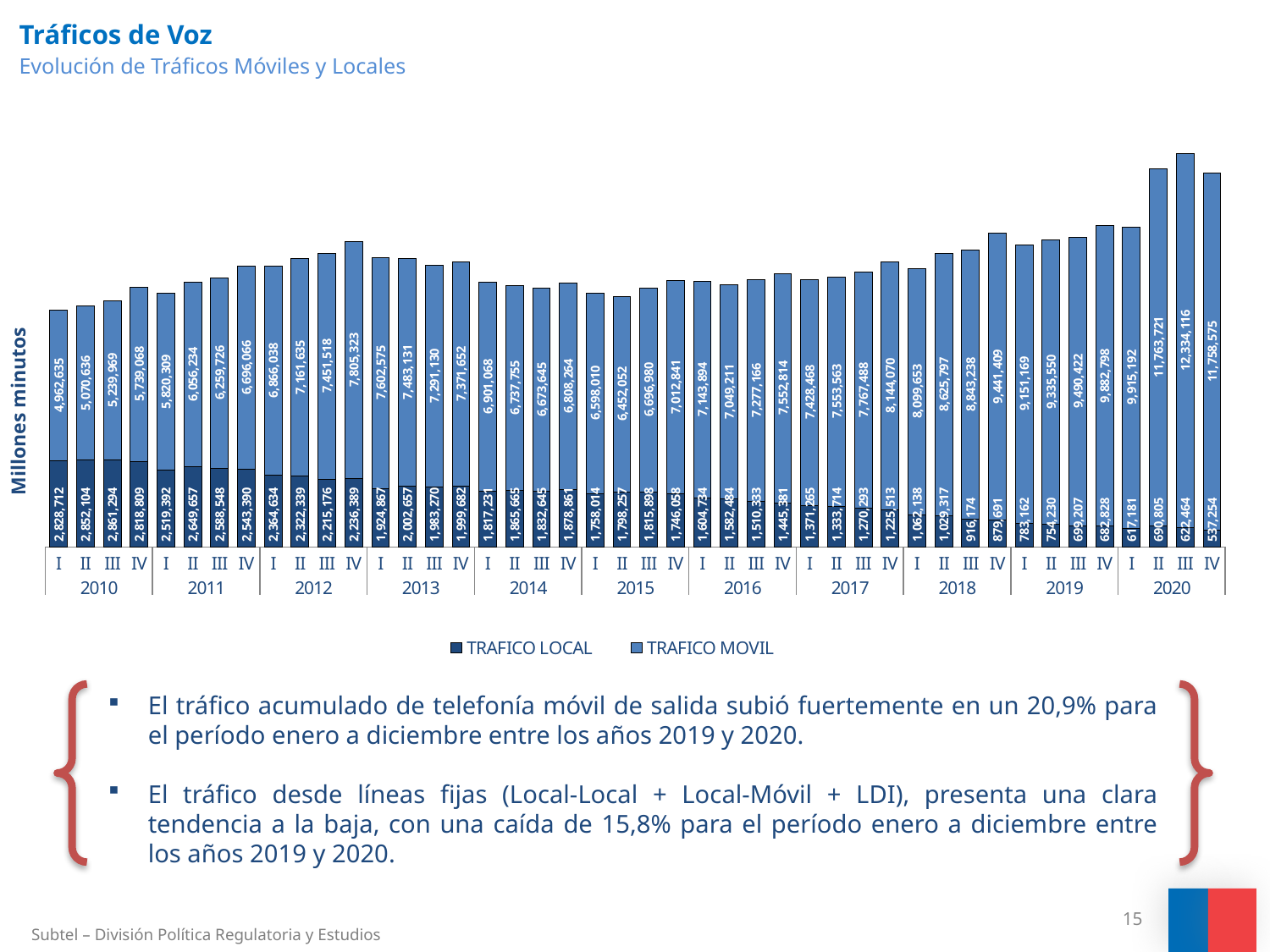
What is the difference between the TRAFICO MOVIL values for quarter III of 2020 and quarter II of 2020? 570,395 Which quarter has the lowest TRAFICO LOCAL value? IV 2020 How many series does the legend list? 2 Which quarter has the highest TRAFICO MOVIL value? III 2020 What is the TRAFICO MOVIL value for quarter III of 2020? 12,334,116 Does the TRAFICO LOCAL value generally rise or fall from 2010 to 2020? Fall What is the total of the stacked bar for quarter III of 2020 (TRAFICO LOCAL plus TRAFICO MOVIL)? 12,956,580 What is the TRAFICO LOCAL value for quarter IV of 2020? 537,254 What is the TRAFICO MOVIL value for quarter I of 2010? 4,962,635 How many quarterly bars are plotted in the chart? 44 What kind of chart is shown on the slide? Stacked bar chart Which is larger, the TRAFICO LOCAL value for quarter I of 2010 or for quarter I of 2020? I 2010